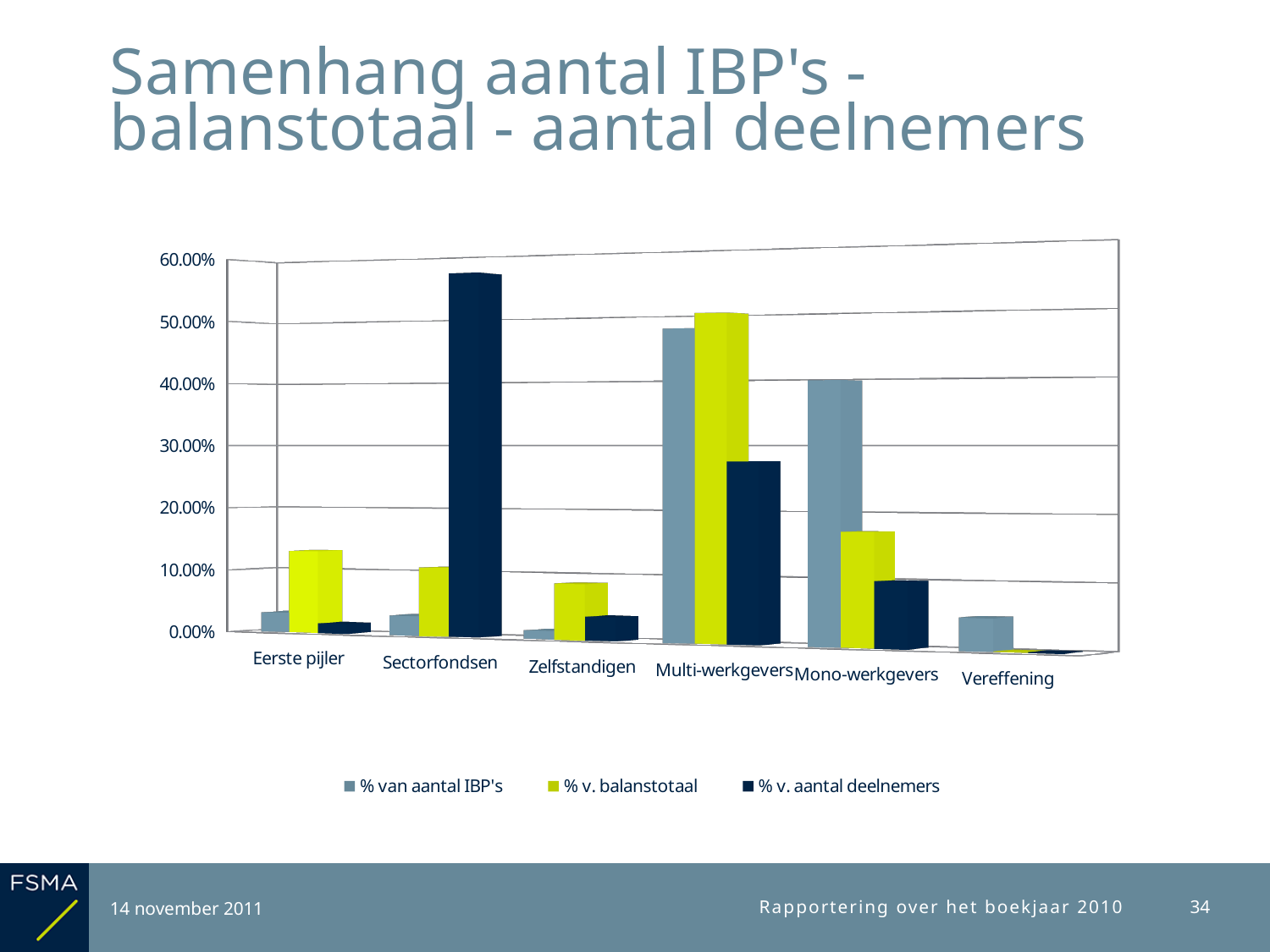
How many series does the legend list? 3 Which category has the lowest value for the series '% v. aantal deelnemers'? Vereffening For the series '% v. aantal deelnemers', which is larger: Sectorfondsen or Multi-werkgevers? Sectorfondsen What is the name of the third series listed in the legend? % v. aantal deelnemers Is the value for Zelfstandigen in the series '% v. balanstotaal' greater or less than 10.00%? less How many categories are shown on the x axis of the chart? 6 Which category has the highest value for the series '% v. balanstotaal'? Multi-werkgevers What kind of chart is shown on the slide? bar chart Is the value for Sectorfondsen in the series '% v. aantal deelnemers' greater or less than 50.00%? greater Is the value for Mono-werkgevers in the series '% van aantal IBP's' greater or less than 30.00%? greater Which category has the highest value for the series '% v. aantal deelnemers'? Sectorfondsen Which category has the highest value for the series '% van aantal IBP's'? Multi-werkgevers